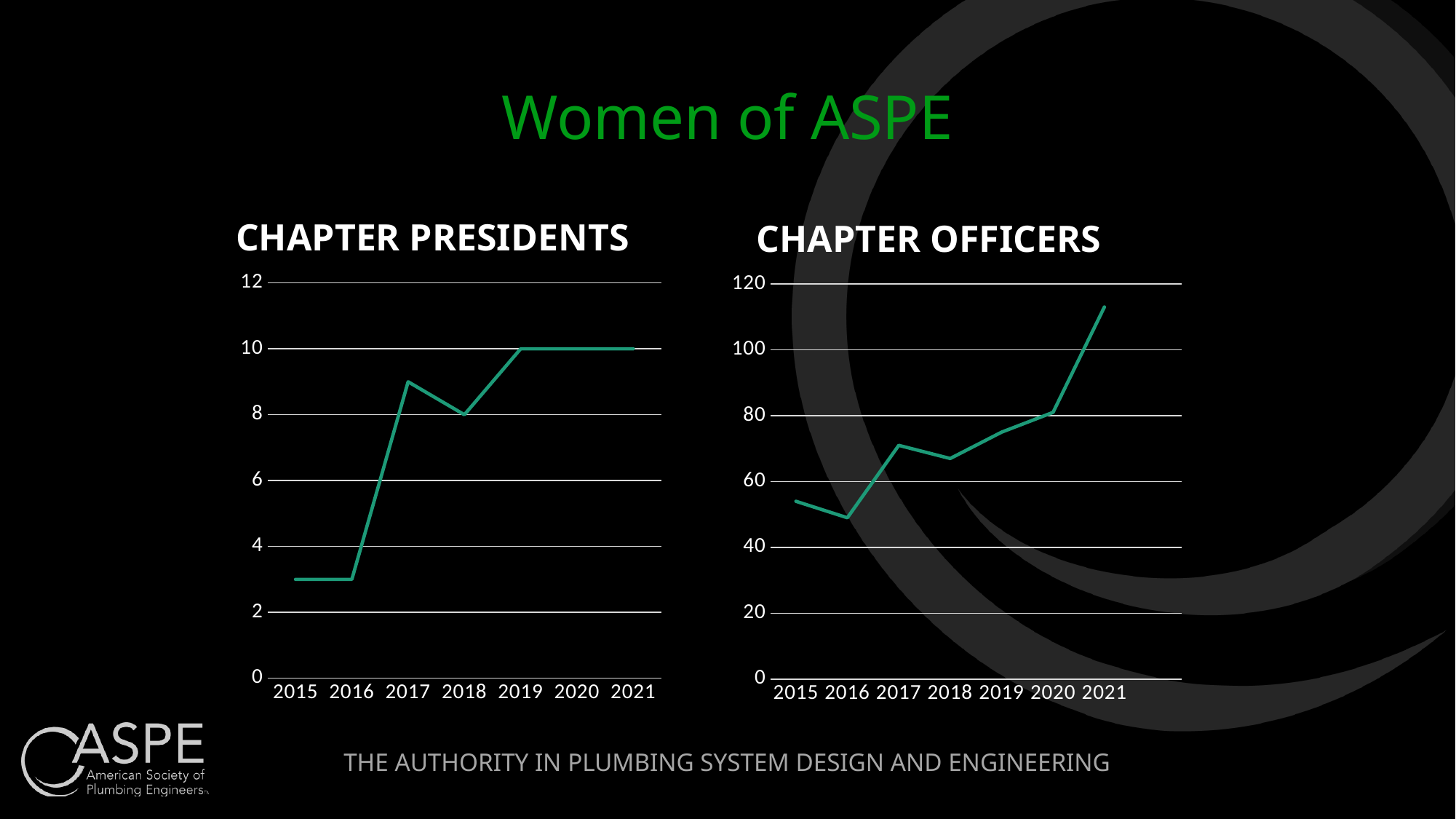
On the Chapter Officers chart, is the value for 2016 greater or less than 60? less On the Chapter Officers chart, is the value for 2021 greater or less than 100? greater On the Chapter Presidents chart, which is larger, the value for 2017 or the value for 2018? 2017 On the Chapter Officers chart, which year has the highest value? 2021 What is the title of the slide containing the two charts? Women of ASPE On the Chapter Presidents chart, what is the value for 2018? 8 On the Chapter Presidents chart, is the value for 2015 greater or less than 4? less How many years are plotted on the Chapter Officers chart? 7 What kind of chart is the Chapter Presidents chart? line chart On the Chapter Presidents chart, what is the value for 2019? 10 On the Chapter Officers chart, do the values generally rise or fall from 2016 to 2021? rise On the Chapter Officers chart, which year has the lowest value? 2016